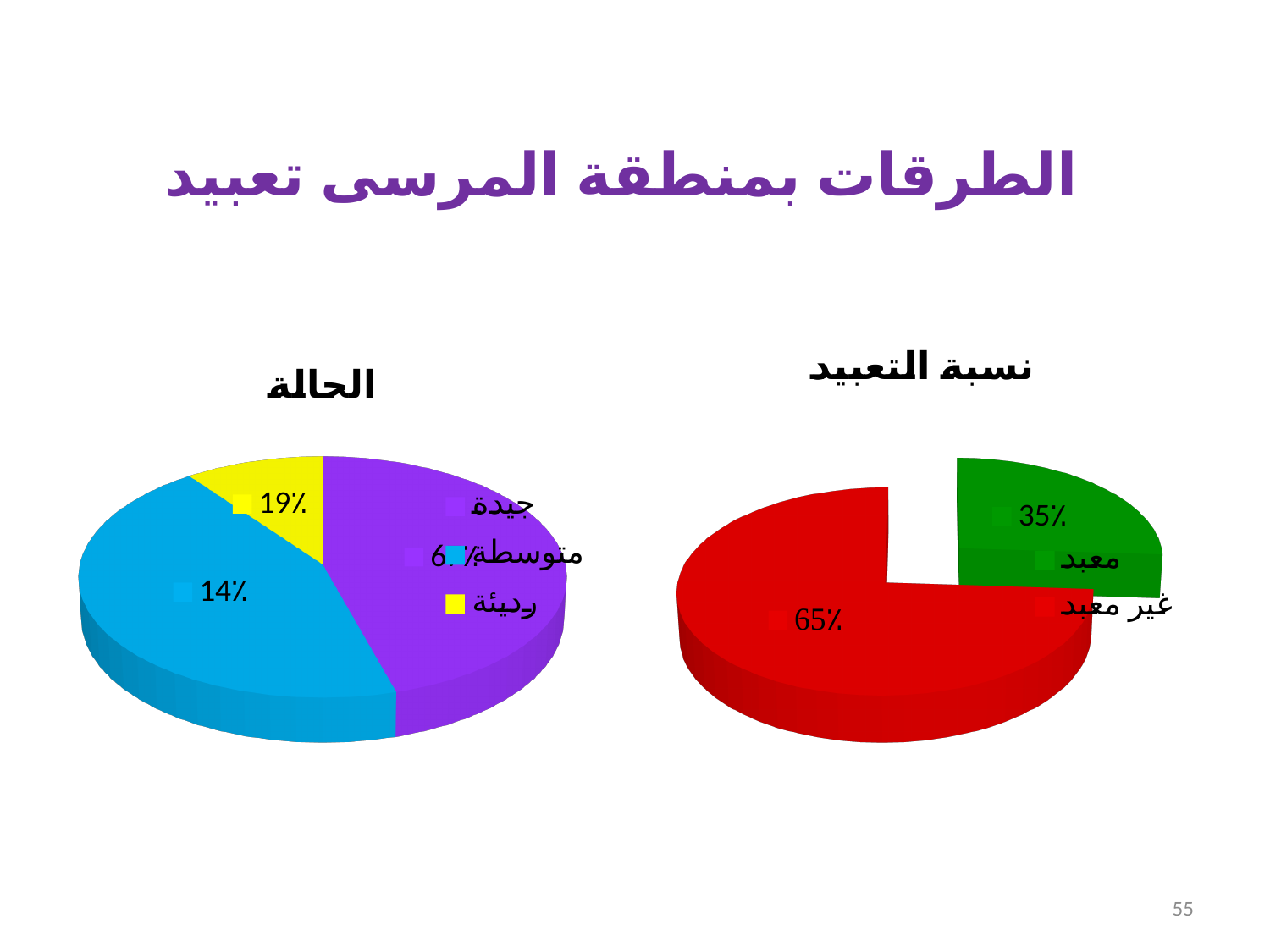
In the chart titled نسبة التعبيد, what is the difference in percentage points between غير معبد and معبد? 30 In the chart titled نسبة التعبيد, what percentage is shown for غير معبد? 65% In the chart titled نسبة التعبيد, what percentage is shown for معبد? 35% What type of chart is the chart titled الحالة? Pie chart In the chart titled نسبة التعبيد, which category has the largest share? غير معبد In the chart titled الحالة, what percentage label is printed on the رديئة (yellow) slice? 19% In the chart titled نسبة التعبيد, how many slices does the pie have? 2 What type of chart is the chart titled نسبة التعبيد? Pie chart In the chart titled نسبة التعبيد, which category has the smallest share? معبد In the chart titled نسبة التعبيد, which is larger: معبد or غير معبد? غير معبد In the chart titled الحالة, how many categories does the legend list? 3 In the chart titled نسبة التعبيد, what colour is the slice for غير معبد? Red